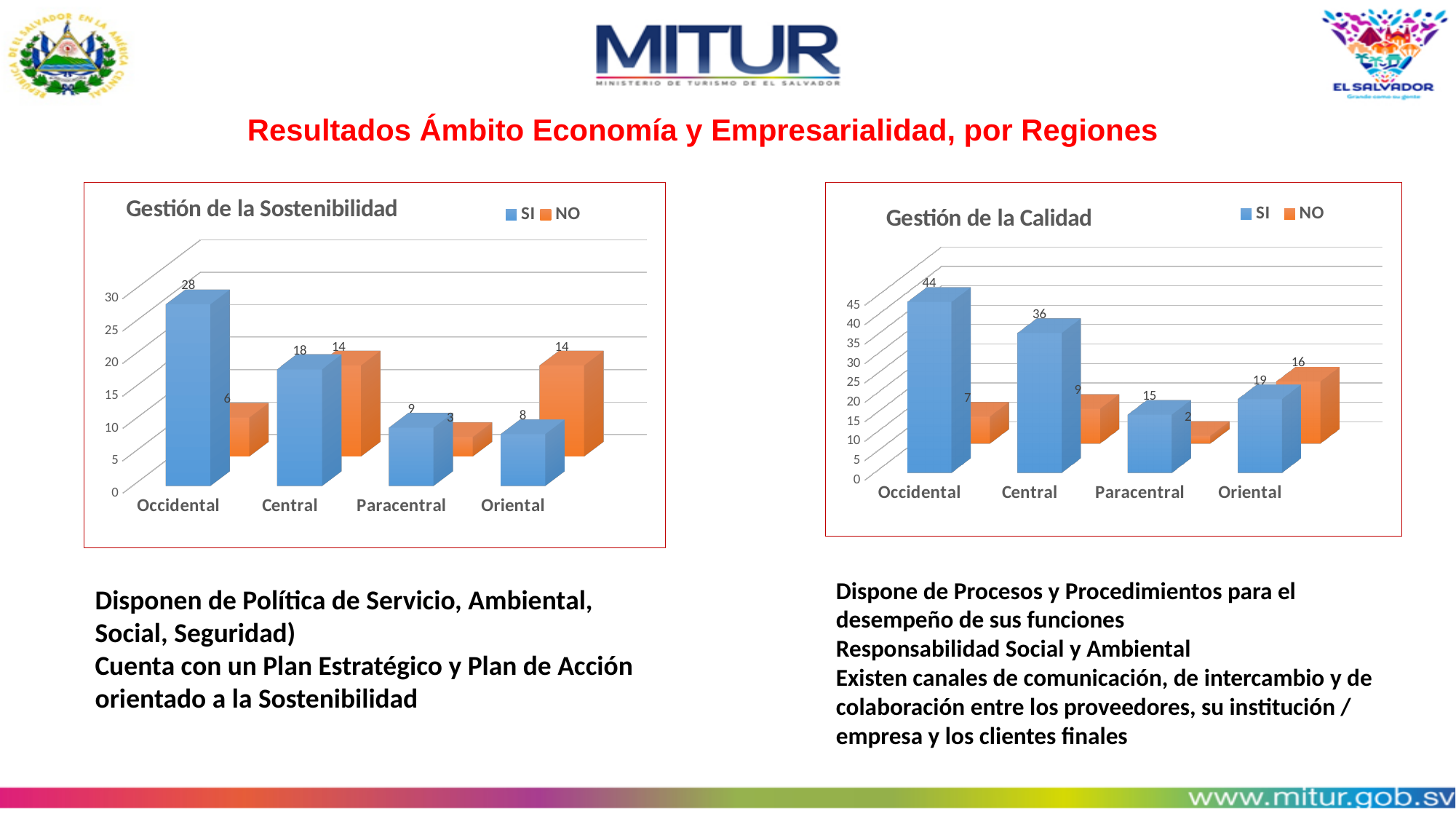
In the 'Gestión de la Sostenibilidad' chart, which region has the lowest NO value? Paracentral In the 'Gestión de la Calidad' chart, what is the SI value for Central? 36 In the 'Gestión de la Sostenibilidad' chart, what is the difference between the SI and NO values for Central? 4 In the 'Gestión de la Calidad' chart, what is the difference between the SI values for Occidental and Central? 8 How many series does the legend of the 'Gestión de la Sostenibilidad' chart list? 2 In the 'Gestión de la Calidad' chart, is the SI value or the NO value larger for Oriental? SI In the 'Gestión de la Sostenibilidad' chart, which region has the highest SI value? Occidental In the 'Gestión de la Calidad' chart, which region has the highest SI value? Occidental In the 'Gestión de la Calidad' chart, what is the NO value for Paracentral? 2 How many regions are shown on the x axis of the 'Gestión de la Calidad' chart? 4 In the 'Gestión de la Sostenibilidad' chart, what is the NO value for Oriental? 14 In the 'Gestión de la Sostenibilidad' chart, what is the SI value for Occidental? 28